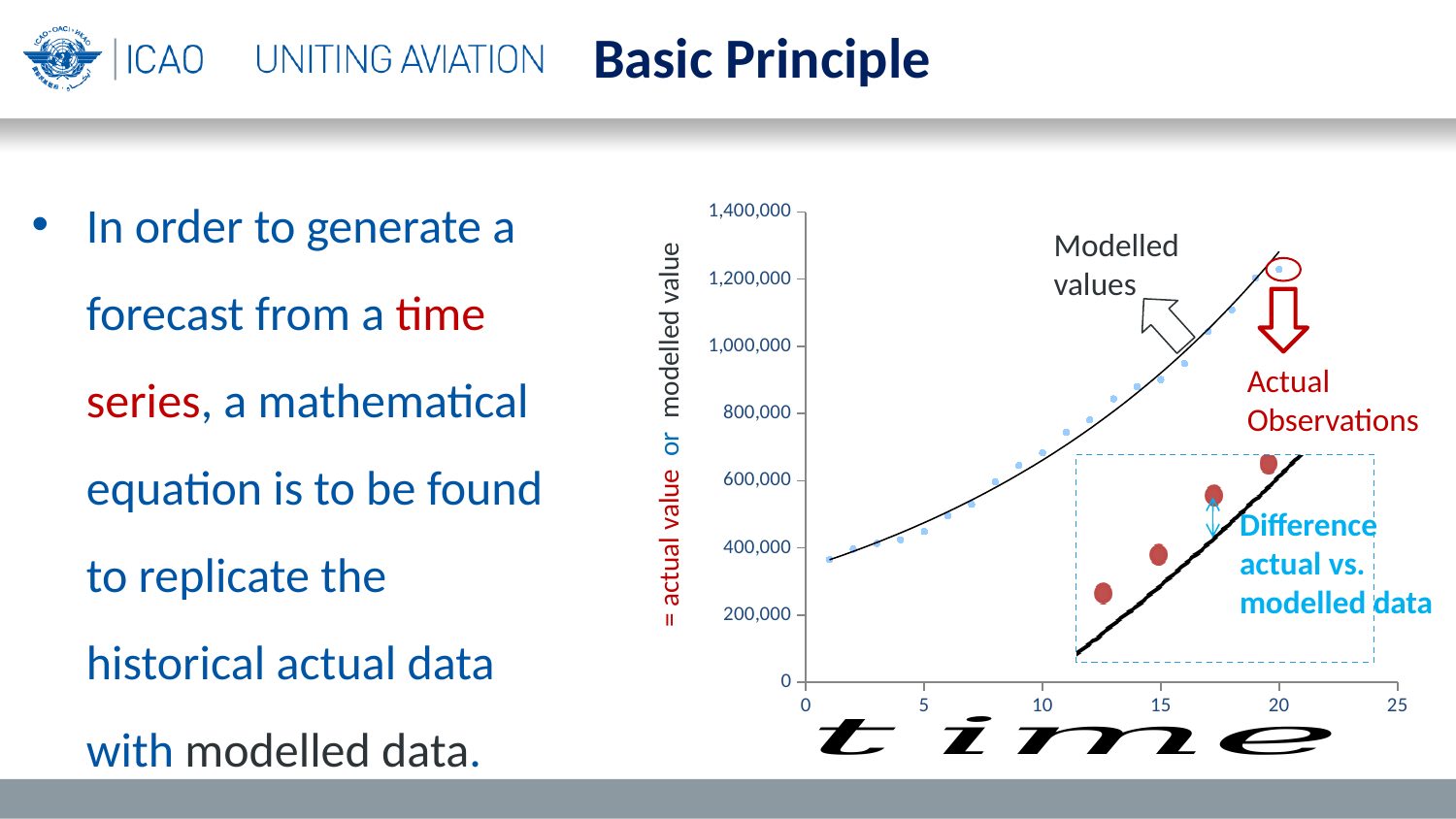
What is the label of the x axis of the chart? time At which time value does the lowest plotted point occur? 1 Is the plotted value at time 15 greater or less than 800,000? greater What is the highest value shown on the y axis? 1,400,000 At which time value does the highest plotted point occur? 20 Is the plotted value at time 5 greater or less than 600,000? less What kind of chart is shown on the slide? scatter chart Which is larger, the plotted value at time 5 or the plotted value at time 15? time 15 Is the plotted value at time 1 greater or less than 400,000? less Do the plotted values rise or fall as time increases along the x axis? rise